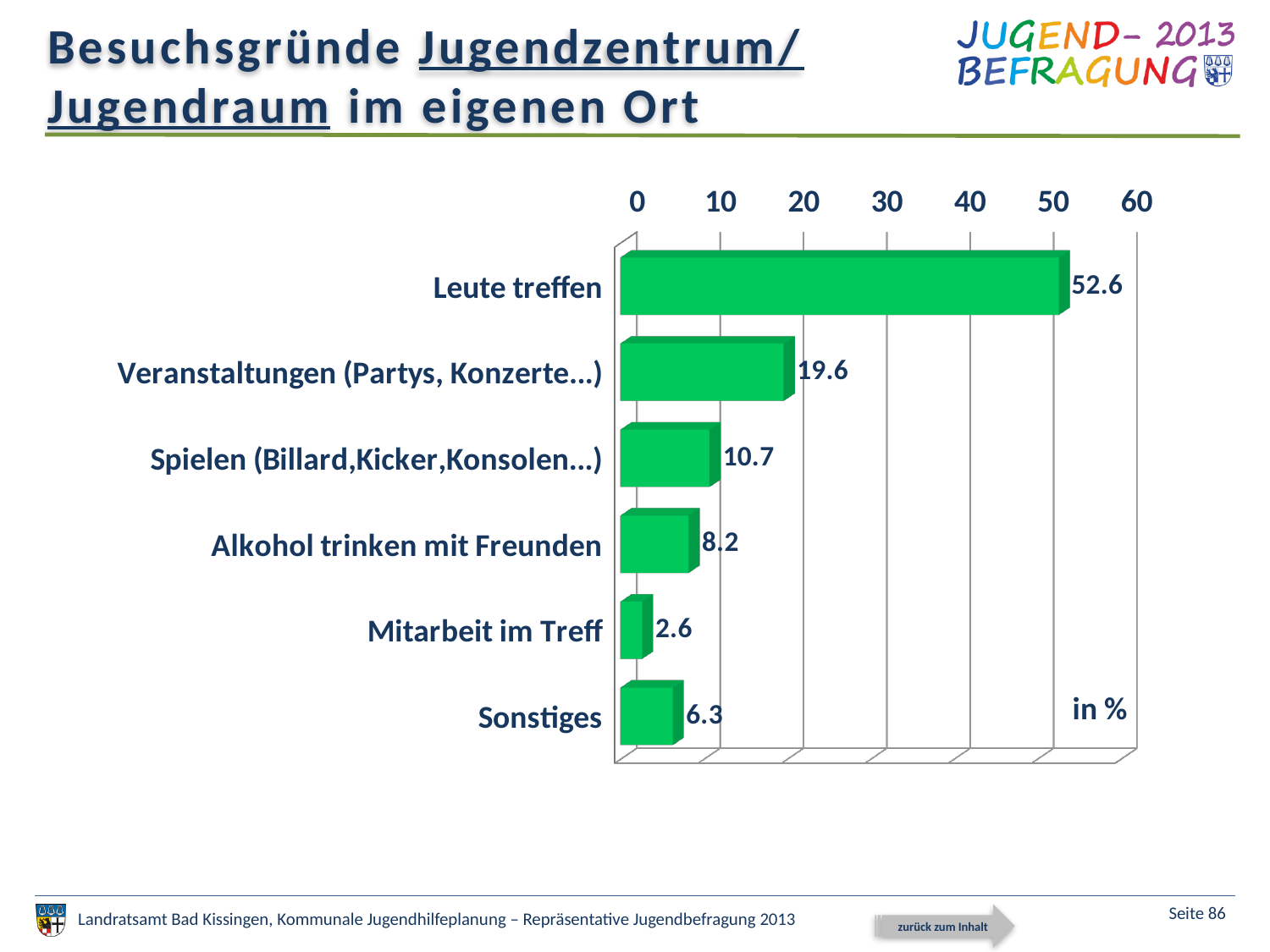
How many categories are shown in the chart? 6 What is the difference between the values for Leute treffen and Veranstaltungen (Partys, Konzerte...)? 33 Which category has the highest value? Leute treffen Which category has the lowest value? Mitarbeit im Treff What kind of chart is shown on the slide? bar chart What is the value for Mitarbeit im Treff? 2.6 What is the value for Leute treffen? 52.6 What is the value for Veranstaltungen (Partys, Konzerte...)? 19.6 What is the value for Alkohol trinken mit Freunden? 8.2 What is the value for Spielen (Billard,Kicker,Konsolen...)? 10.7 Is the value for Leute treffen greater or less than 50? greater Which is larger, the value for Sonstiges or the value for Alkohol trinken mit Freunden? Alkohol trinken mit Freunden